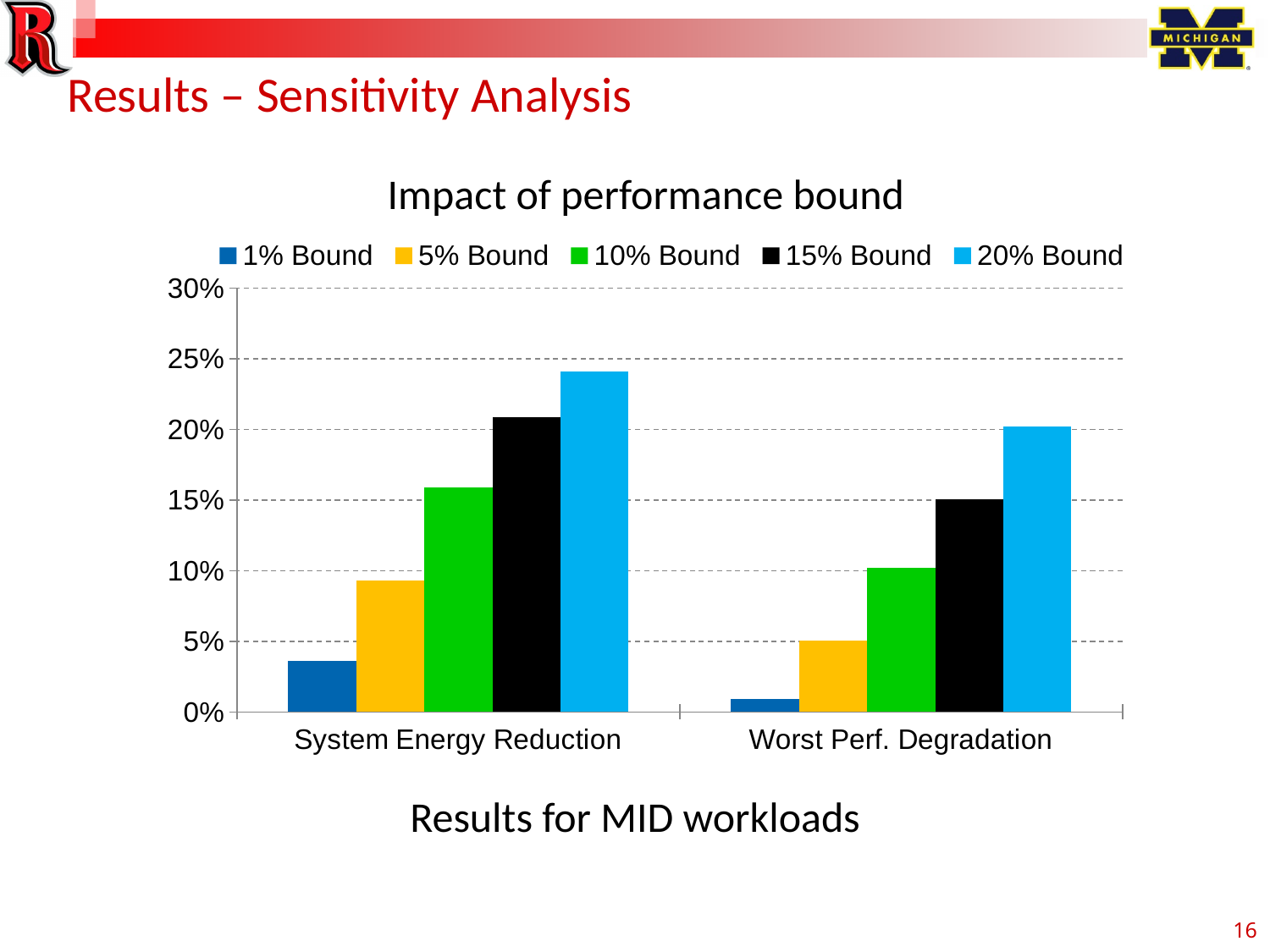
Which series has the lowest value for Worst Perf. Degradation? 1% Bound How many categories are shown on the x axis? 2 Which series has the highest value for System Energy Reduction? 20% Bound What is the title of the chart? Impact of performance bound For the 15% Bound series, which category has the larger value: System Energy Reduction or Worst Perf. Degradation? System Energy Reduction How many series does the legend list? 5 Is the 20% Bound value for Worst Perf. Degradation greater or less than 15%? greater Is the 20% Bound value for System Energy Reduction greater or less than 20%? greater Is the 1% Bound value for Worst Perf. Degradation greater or less than 5%? less What kind of chart is shown on the slide? bar chart